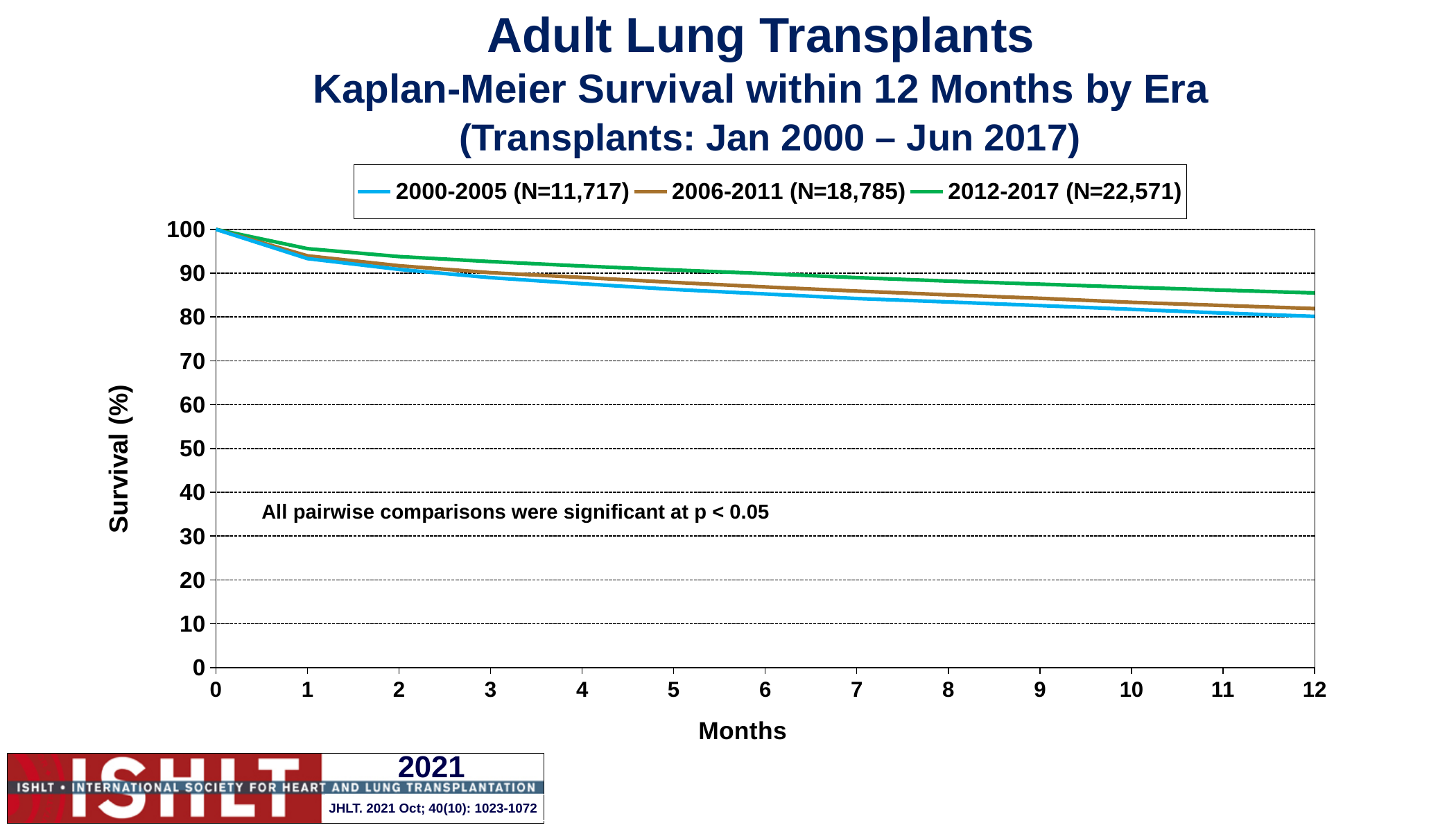
What is the N for the 2006-2011 era shown in the legend? 18,785 At 6 months, which era has higher survival: 2012-2017 or 2000-2005? 2012-2017 Is the survival for the 2000-2005 era at 1 month greater or less than 90? greater Do the survival curves rise or fall as months increase? fall How many series does the legend list? 3 What is the survival value for all three eras at month 0? 100 Which era has the highest survival at 12 months? 2012-2017 (N=22,571) Is the survival for the 2012-2017 era at 12 months greater or less than 80? greater What does the annotation inside the chart say about pairwise comparisons? All pairwise comparisons were significant at p < 0.05 Is the survival for the 2000-2005 era at 6 months greater or less than 80? greater How many month tick marks are labelled on the x axis? 13 What kind of chart is shown on the slide? line chart